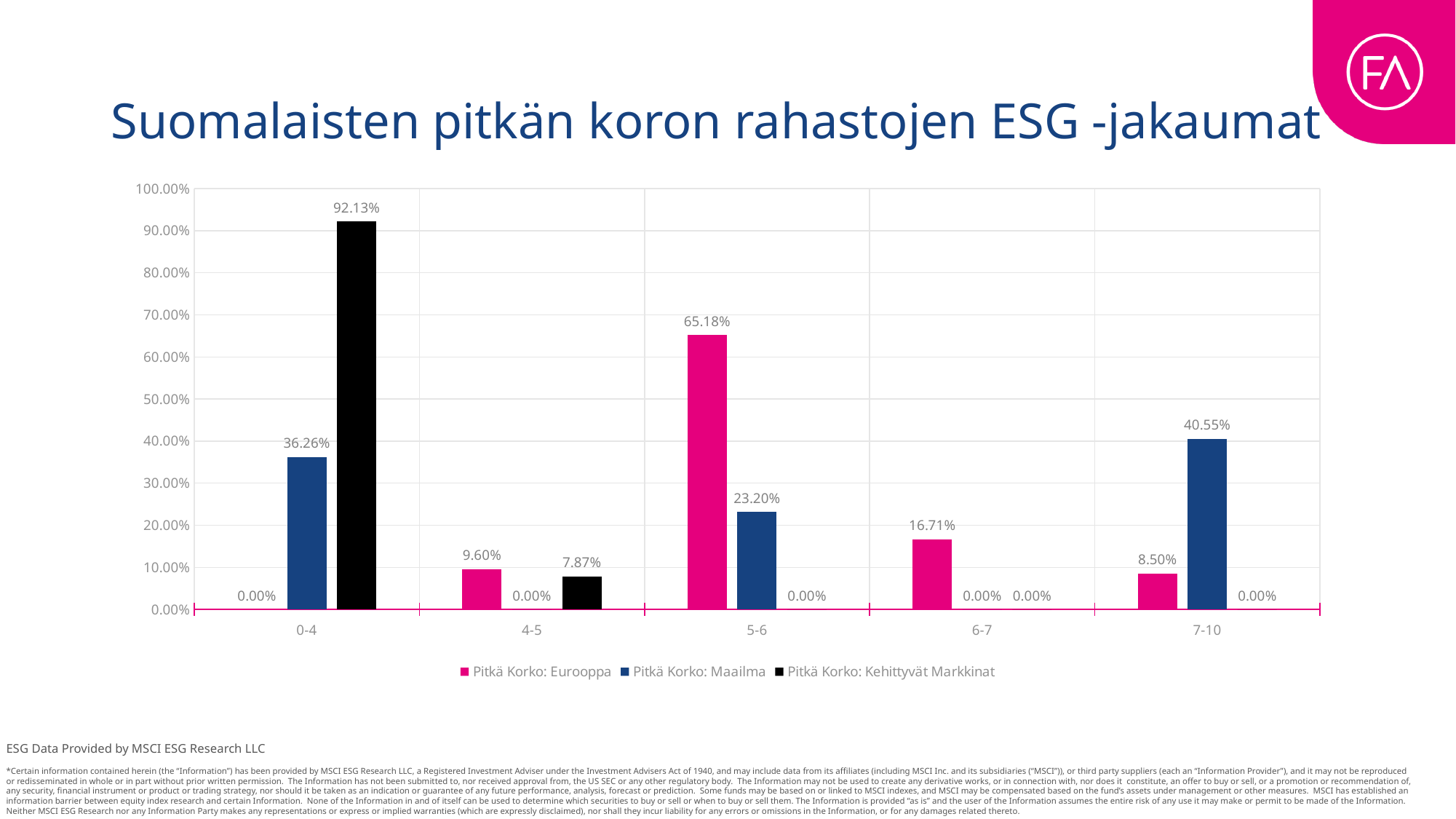
What is the difference between Pitkä Korko: Eurooppa and Pitkä Korko: Maailma in the 5-6 category? 41.98% What is the value for Pitkä Korko: Eurooppa in the 5-6 category? 65.18% What is the value for Pitkä Korko: Eurooppa in the 6-7 category? 16.71% In the 4-5 category, which is larger: Pitkä Korko: Eurooppa or Pitkä Korko: Kehittyvät Markkinat? Pitkä Korko: Eurooppa What is the title of the slide? Suomalaisten pitkän koron rahastojen ESG -jakaumat How many categories are shown on the x axis? 5 In which category does Pitkä Korko: Maailma have its highest value? 7-10 What is the value for Pitkä Korko: Kehittyvät Markkinat in the 0-4 category? 92.13% How many series does the legend list? 3 In which category does Pitkä Korko: Eurooppa have its lowest value? 0-4 What is the value for Pitkä Korko: Maailma in the 7-10 category? 40.55% What kind of chart is shown on the slide? Bar chart